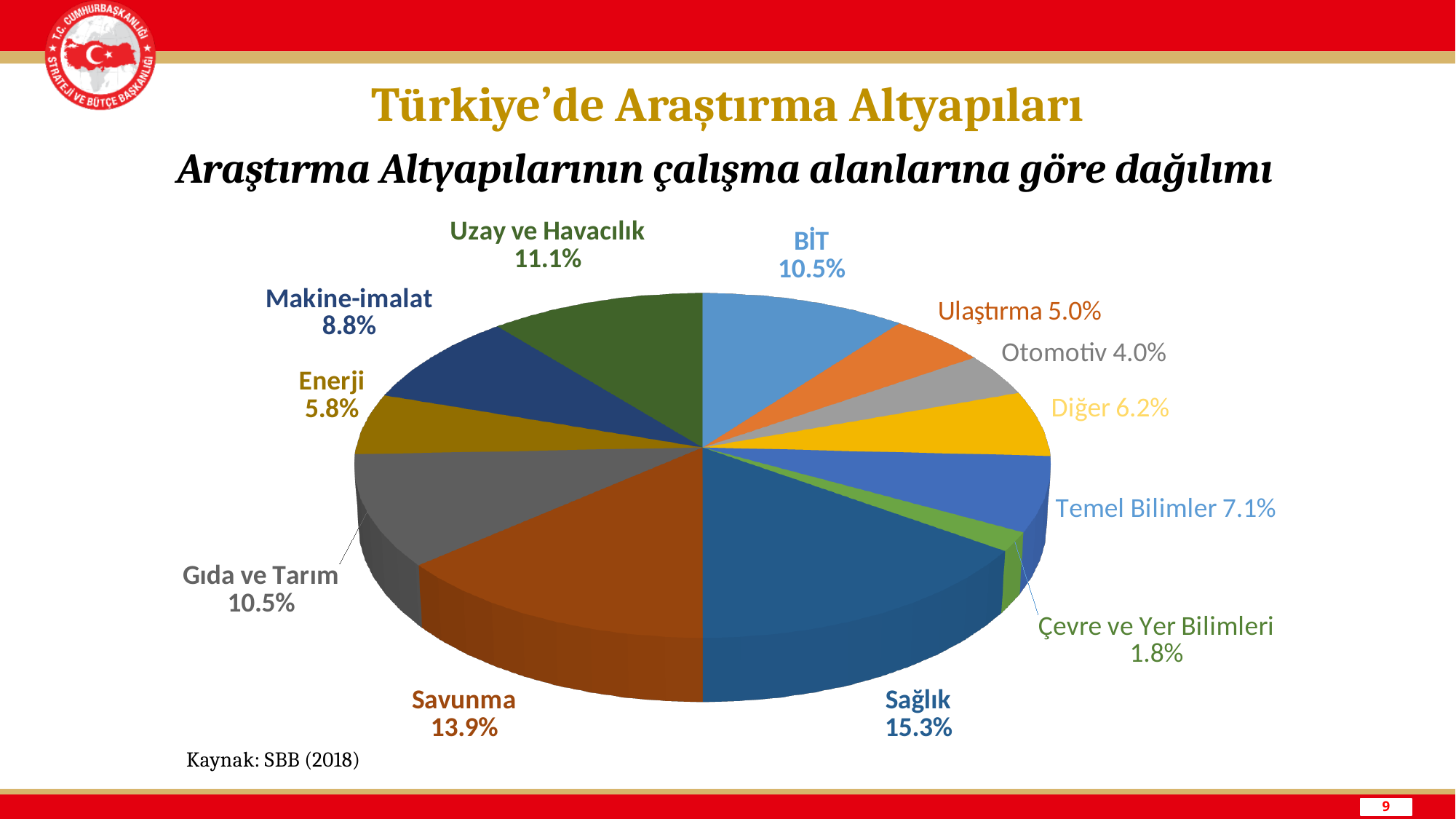
What is the value shown for Çevre ve Yer Bilimleri? 1.8% What is the value shown for Temel Bilimler? 7.1% What is the value shown for Savunma? 13.9% How many categories (slices) does the pie chart have? 12 What kind of chart is shown on the slide? pie chart Which category has the smallest slice of the pie? Çevre ve Yer Bilimleri Which category has the largest slice of the pie? Sağlık What is the difference between the shares of Sağlık and Savunma? 1.4% What source is cited below the chart? Kaynak: SBB (2018) Which is larger, Uzay ve Havacılık or Makine-imalat? Uzay ve Havacılık What is the difference between the shares of Diğer and Otomotiv? 2.2% What share of the pie does Sağlık have? 15.3%